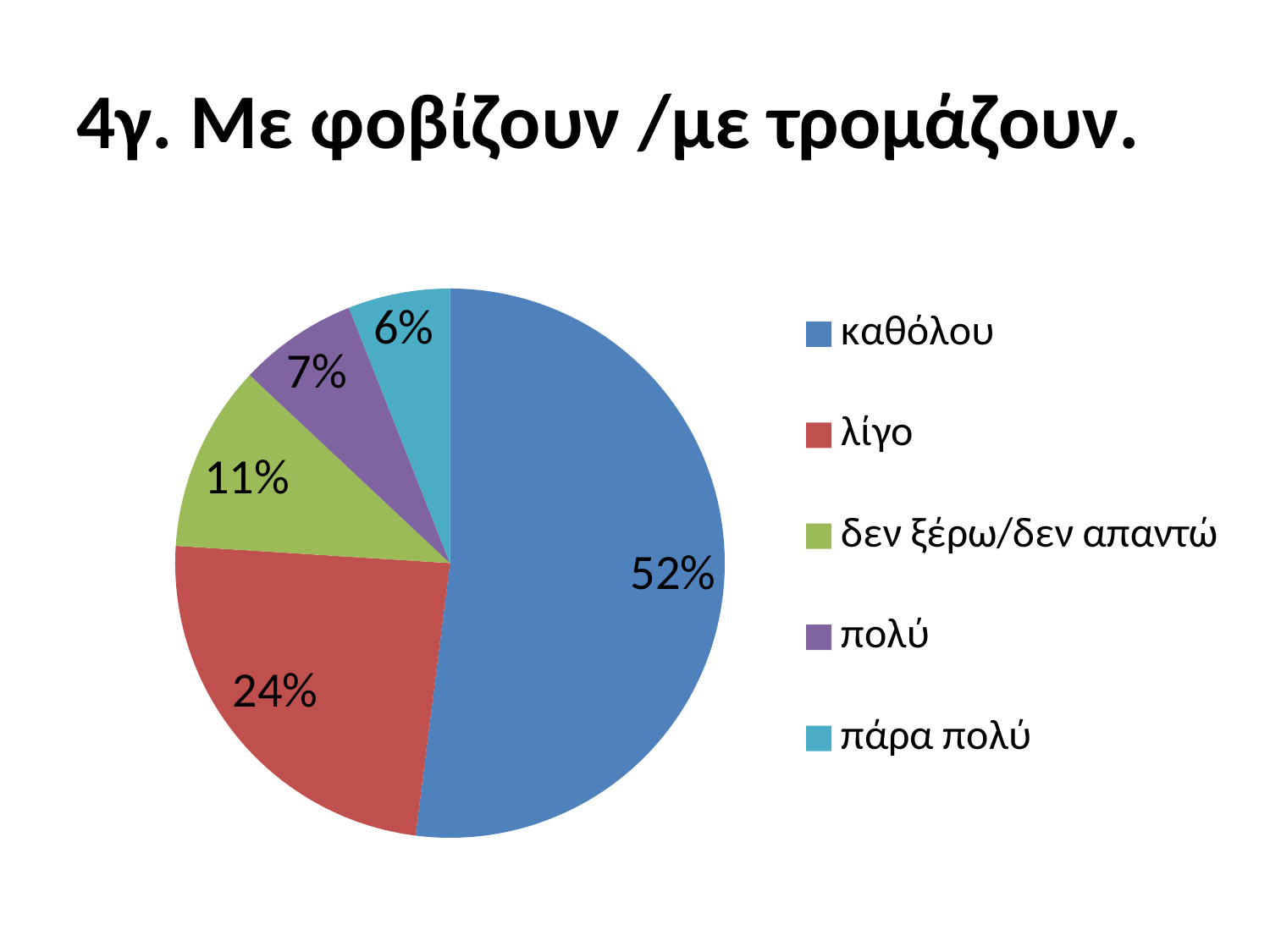
What kind of chart is shown on the slide? pie chart What percentage of the pie is the καθόλου slice? 52% What percentage of the pie is the δεν ξέρω/δεν απαντώ slice? 11% What percentage of the pie is the λίγο slice? 24% What percentage of the pie is the πολύ slice? 7% What is the difference in percentage points between the καθόλου slice and the λίγο slice? 28 What percentage of the pie is the πάρα πολύ slice? 6% Which slice is larger, λίγο or δεν ξέρω/δεν απαντώ? λίγο Which category has the largest slice of the pie? καθόλου How many slices does the pie chart have? 5 What is the title of the slide? 4γ. Με φοβίζουν /με τρομάζουν. Which category has the smallest slice of the pie? πάρα πολύ